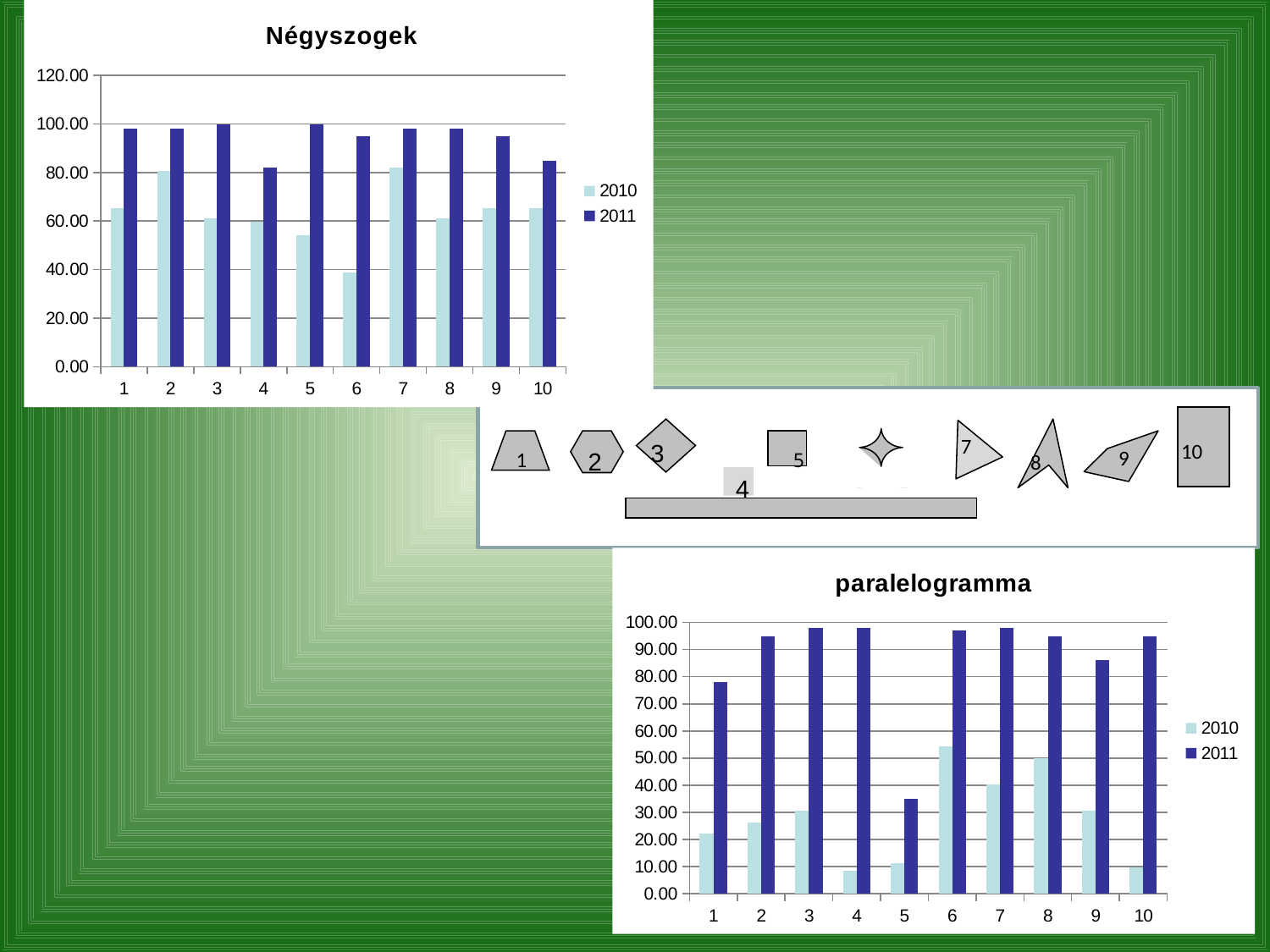
In the 'Négyszogek' chart, which category has the lowest 2010 value? 6 How many series does the legend of the 'Négyszogek' chart list? 2 In the 'Négyszogek' chart, is the 2010 value for category 6 greater or less than 60.00? less In the 'Négyszogek' chart, is the 2011 value for category 5 greater or less than 80.00? greater What kind of chart is the 'Négyszogek' chart? bar chart In the 'paralelogramma' chart, which category has the lowest 2011 value? 5 In the 'Négyszogek' chart, which is larger for category 2: the 2010 value or the 2011 value? 2011 What are the two legend entries of the 'paralelogramma' chart? 2010 and 2011 How many categories are shown on the x axis of the 'paralelogramma' chart? 10 In the 'paralelogramma' chart, which is larger for category 1: the 2010 value or the 2011 value? 2011 In the 'paralelogramma' chart, which category has the highest 2010 value? 6 In the 'paralelogramma' chart, is the 2011 value for category 5 greater or less than 50.00? less